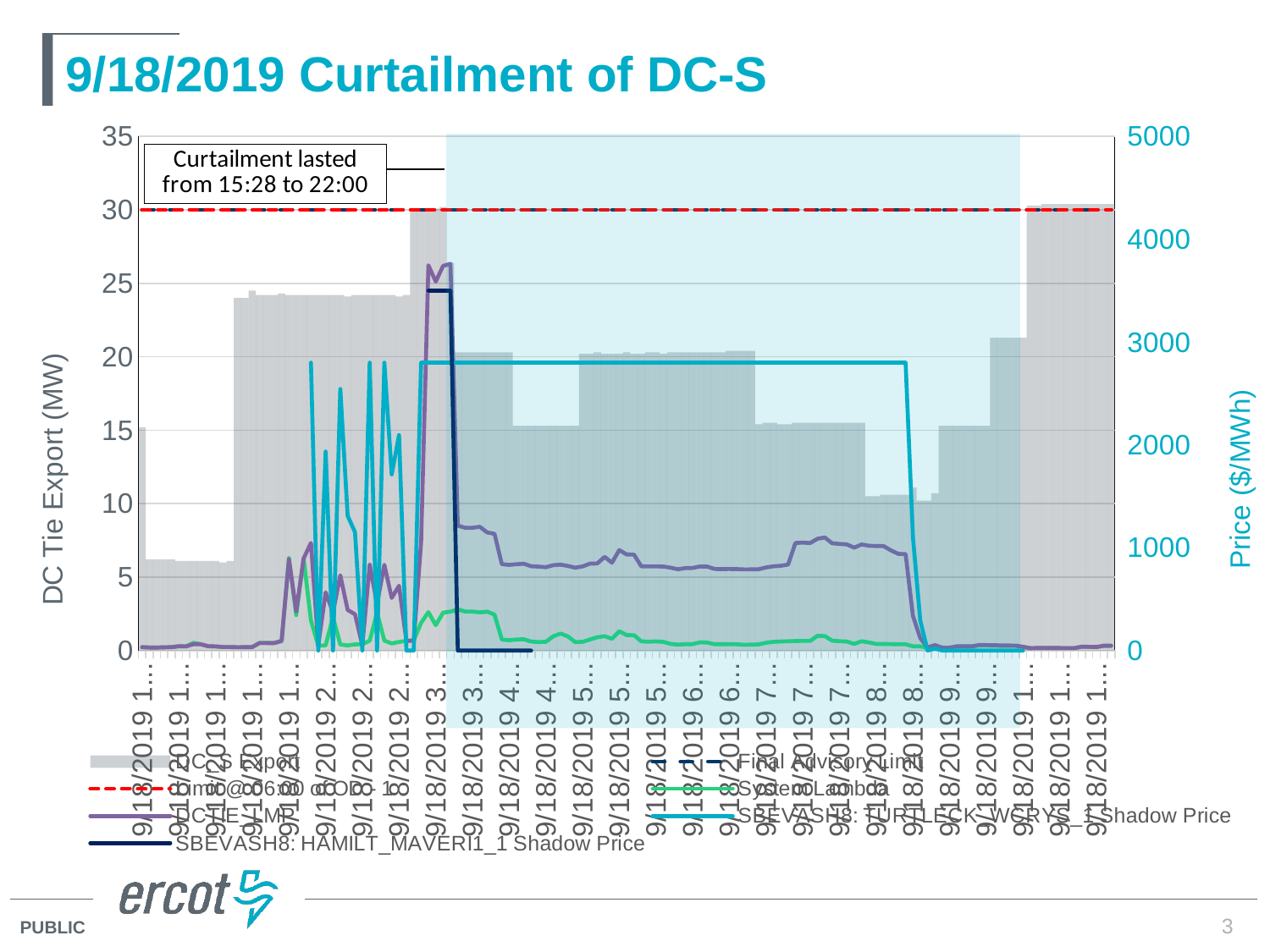
According to the annotation on the chart, at what time did the curtailment start? 15:28 What is the title of the chart on the slide? 9/18/2019 Curtailment of DC-S According to the annotation on the chart, at what time did the curtailment end? 22:00 Is the flat plateau of the SBEVASH8: TURTLECK_WCRYS_1 Shadow Price line greater or less than 2000 $/MWh? greater Is the peak of the System Lambda line greater or less than 1000 $/MWh? less What is the maximum value shown on the left-hand DC Tie Export axis? 35 What is the maximum value shown on the right-hand Price axis? 5000 What is the label of the left vertical axis? DC Tie Export (MW) How many series does the chart legend list? 7 Is the highest value of the DC-S Export series greater or less than 25 MW? greater Which series is drawn as a red dashed line in the chart? Limit @ 06:00 of OD - 1